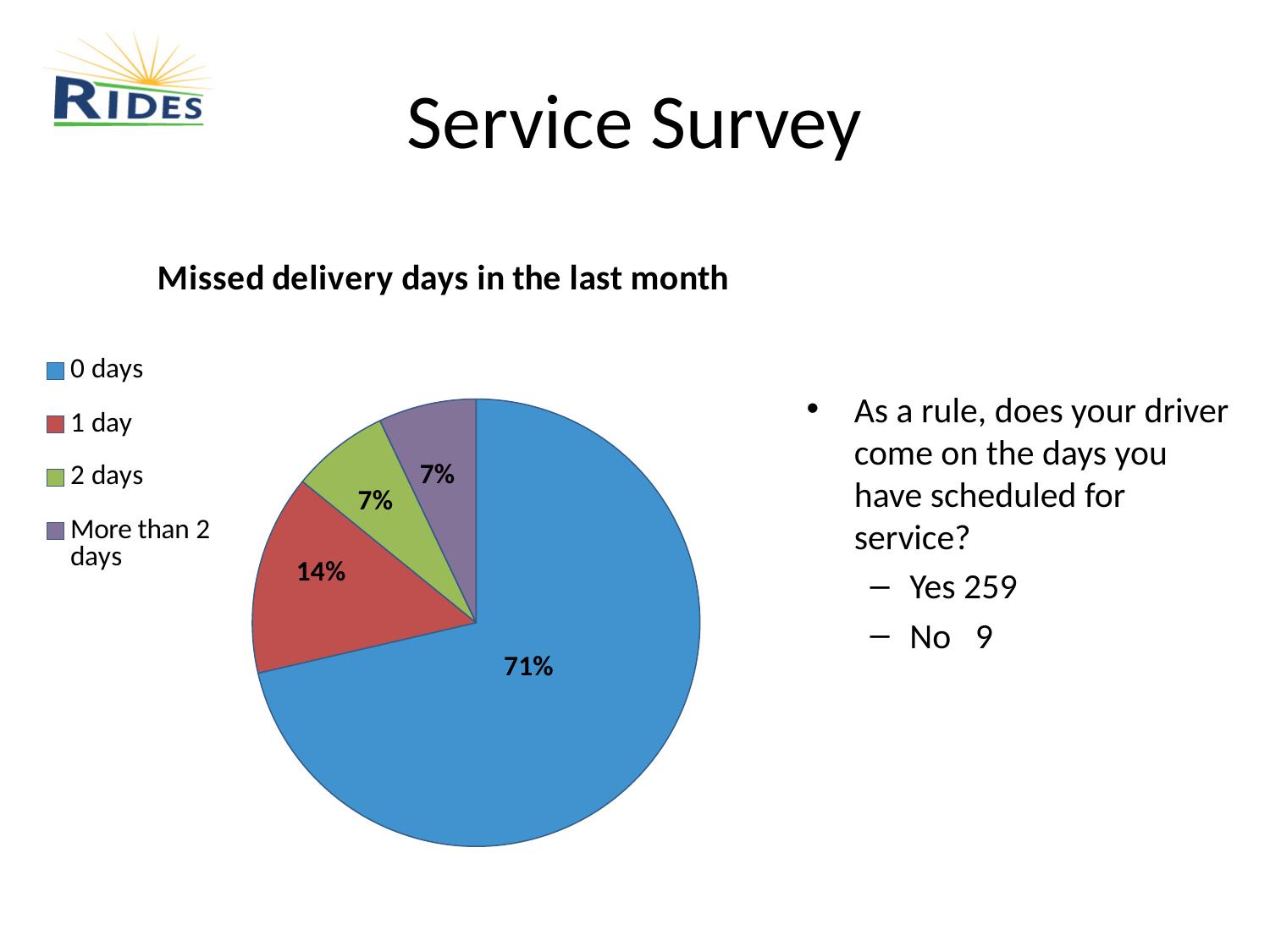
How many categories does the legend list? 4 Which is larger, the "1 day" slice or the "2 days" slice? 1 day What percentage of the pie is the "0 days" slice? 71% Is the share for "0 days" greater or less than 50%? greater What colour is the "0 days" slice? blue What type of chart is shown on the slide? pie chart What percentage of the pie is the "More than 2 days" slice? 7% What is the difference in percentage points between the "0 days" slice and the "1 day" slice? 57 What percentage of the pie is the "2 days" slice? 7% What percentage of the pie is the "1 day" slice? 14% What is the title of the chart? Missed delivery days in the last month Which category has the largest share of the pie? 0 days